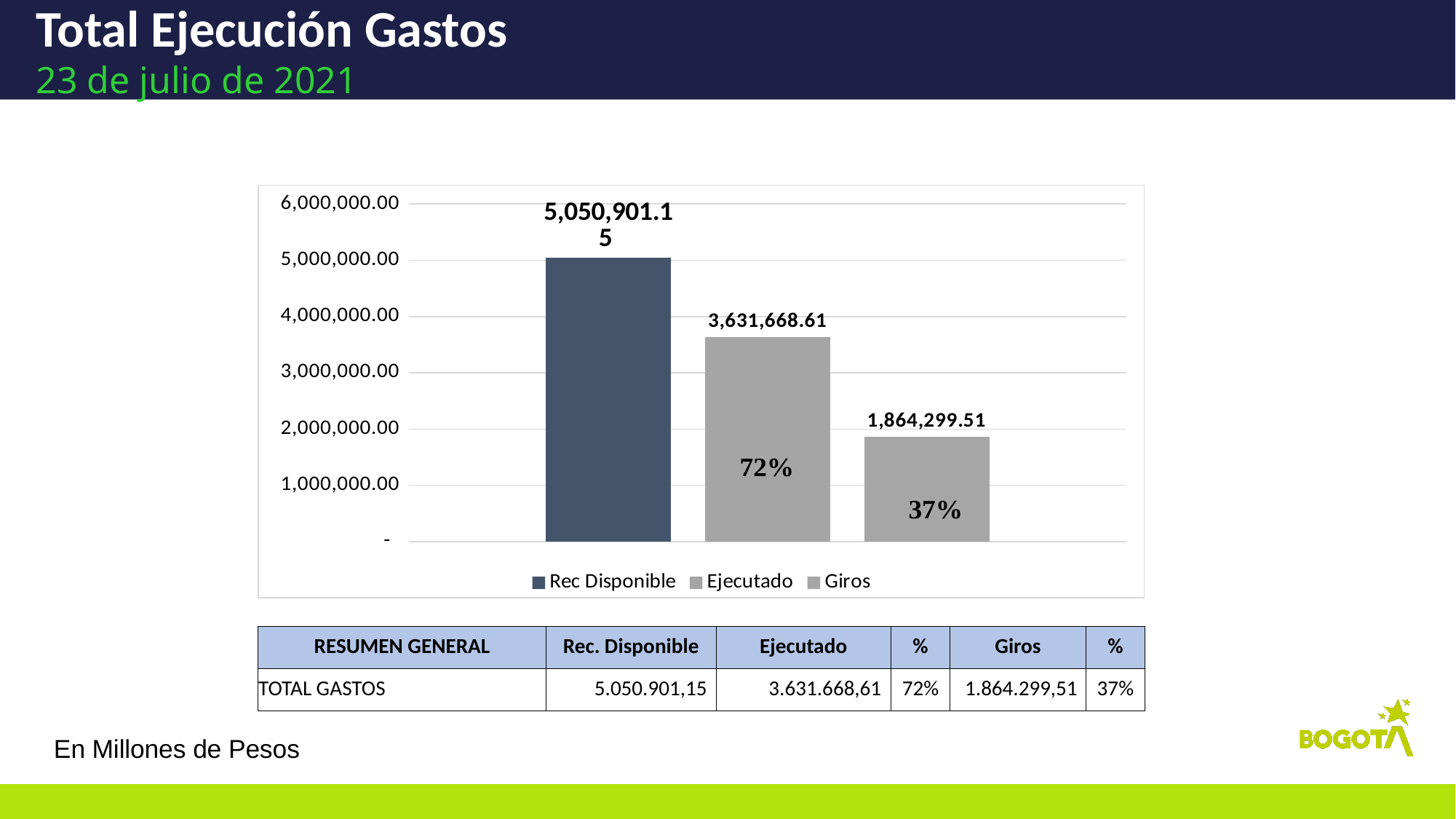
What percentage is printed on the Giros bar? 37% What is the value of the Rec Disponible bar? 5,050,901.15 What kind of chart is shown on the slide? Bar chart What is the value of the Giros bar? 1,864,299.51 Which series has the lowest value? Giros What is the value of the Ejecutado bar? 3,631,668.61 What is the difference between the Ejecutado and Giros values? 1,767,369.10 Which is larger, Ejecutado or Giros? Ejecutado Which series has the highest value? Rec Disponible How many series does the legend list? 3 What percentage is printed on the Ejecutado bar? 72% What is the difference between the Rec Disponible and Ejecutado values? 1,419,232.54